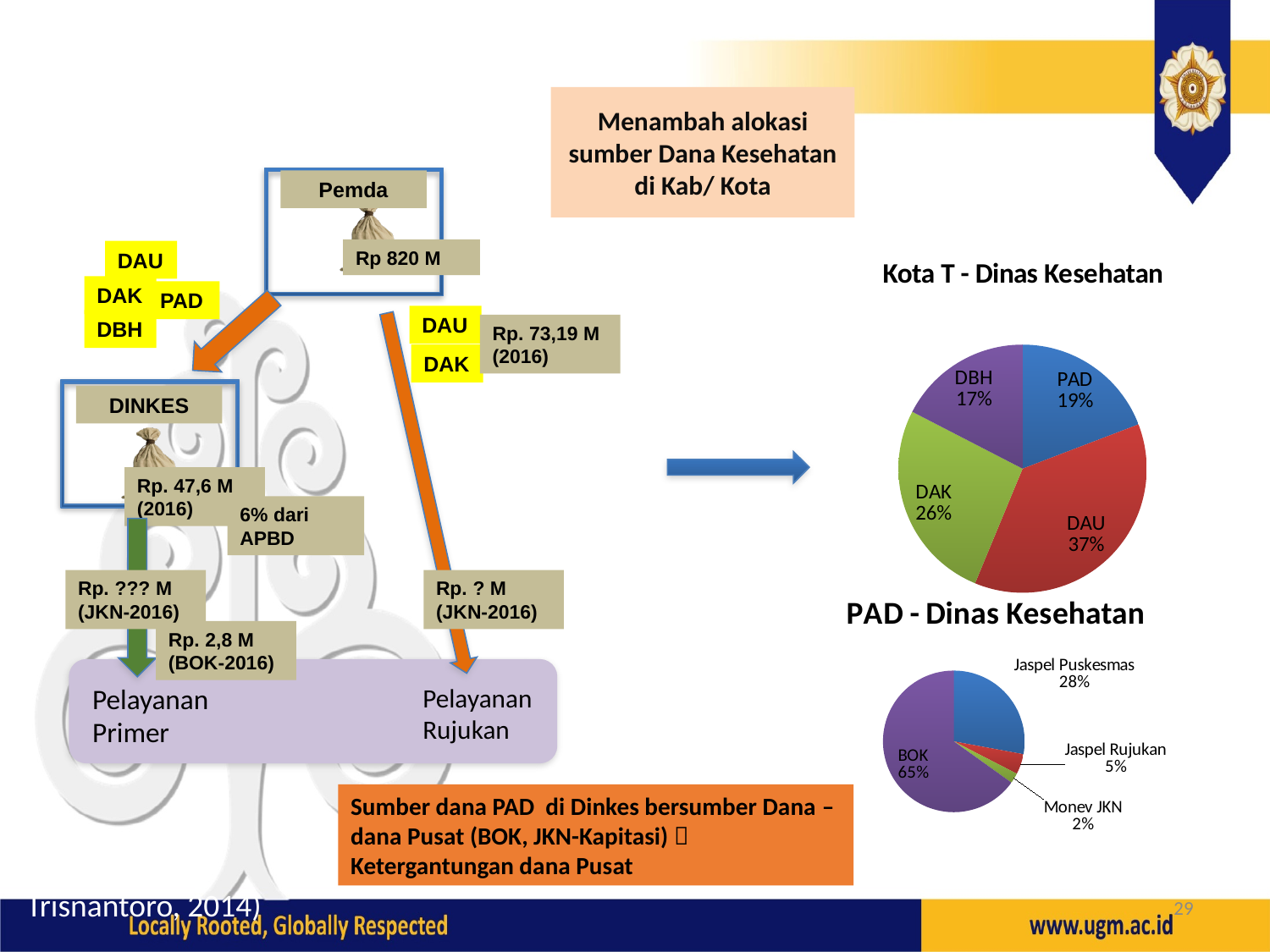
In the 'Kota T - Dinas Kesehatan' chart, how many slices are there? 4 In the 'PAD - Dinas Kesehatan' chart, what is the difference in percentage points between BOK and Jaspel Puskesmas? 37 In the 'Kota T - Dinas Kesehatan' chart, what is the difference in percentage points between DAK and PAD? 7 In the 'PAD - Dinas Kesehatan' chart, what share does BOK have? 65% What type of chart is 'Kota T - Dinas Kesehatan'? pie chart In the 'PAD - Dinas Kesehatan' chart, which is larger: Jaspel Rujukan or Monev JKN? Jaspel Rujukan In the 'PAD - Dinas Kesehatan' chart, which category has the smallest share? Monev JKN In the 'Kota T - Dinas Kesehatan' chart, what share does DAU have? 37% In the 'Kota T - Dinas Kesehatan' chart, which category has the smallest share? DBH In the 'Kota T - Dinas Kesehatan' chart, which category has the largest share? DAU In the 'Kota T - Dinas Kesehatan' chart, what share does DBH have? 17% In the 'PAD - Dinas Kesehatan' chart, what share does Jaspel Puskesmas have? 28%